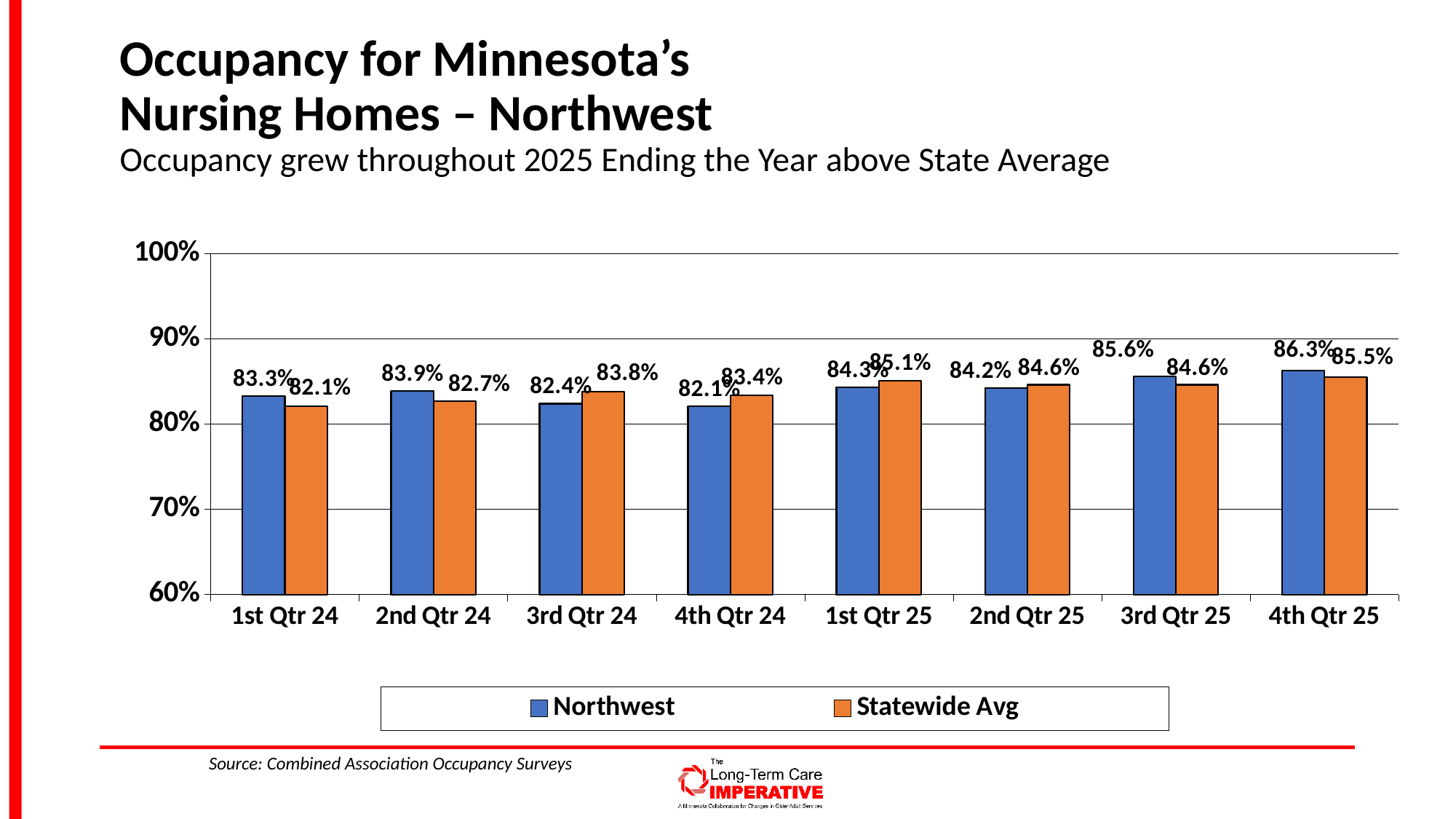
Is the Northwest value for 4th Qtr 24 greater or less than 90%? less How many series does the legend list? 2 Does the Northwest occupancy rise or fall from 4th Qtr 24 to 4th Qtr 25? rise What colour represents the Statewide Avg series in the legend? orange How many quarters are shown on the x axis? 8 In which quarter is the Northwest occupancy highest? 4th Qtr 25 What is the Statewide Avg occupancy value for 3rd Qtr 24? 83.8% In 1st Qtr 25, which is larger: Northwest or Statewide Avg? Statewide Avg In which quarter is the Statewide Avg occupancy lowest? 1st Qtr 24 What kind of chart is shown on the slide? bar chart What is the difference between the Northwest and Statewide Avg values in 4th Qtr 25? 0.8% What is the Northwest occupancy value for 4th Qtr 25? 86.3%